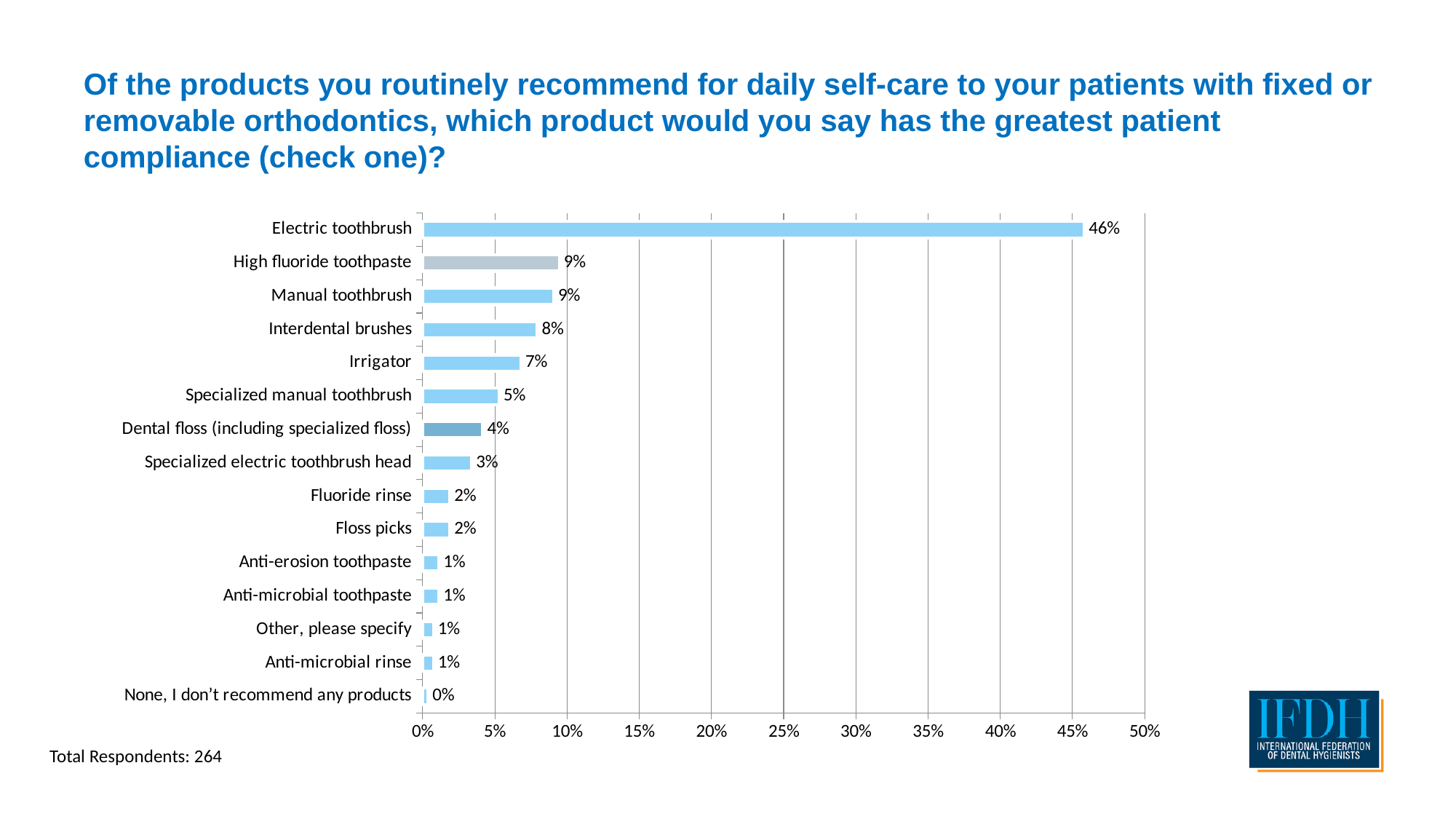
What is the difference between the values for Electric toothbrush and Interdental brushes? 38% What value is shown for Irrigator? 7% What kind of chart is shown on the slide? Bar chart What value is shown for Dental floss (including specialized floss)? 4% Which product has the highest percentage? Electric toothbrush What is the total number of respondents stated on the slide? 264 How many product categories are shown on the chart? 15 Which is larger, the value for Irrigator or the value for Specialized manual toothbrush? Irrigator What percentage of respondents chose Electric toothbrush as the product with the greatest patient compliance? 46% Is the value for Electric toothbrush greater or less than 40%? greater Which category has the lowest percentage? None, I don't recommend any products What value is shown for Interdental brushes? 8%